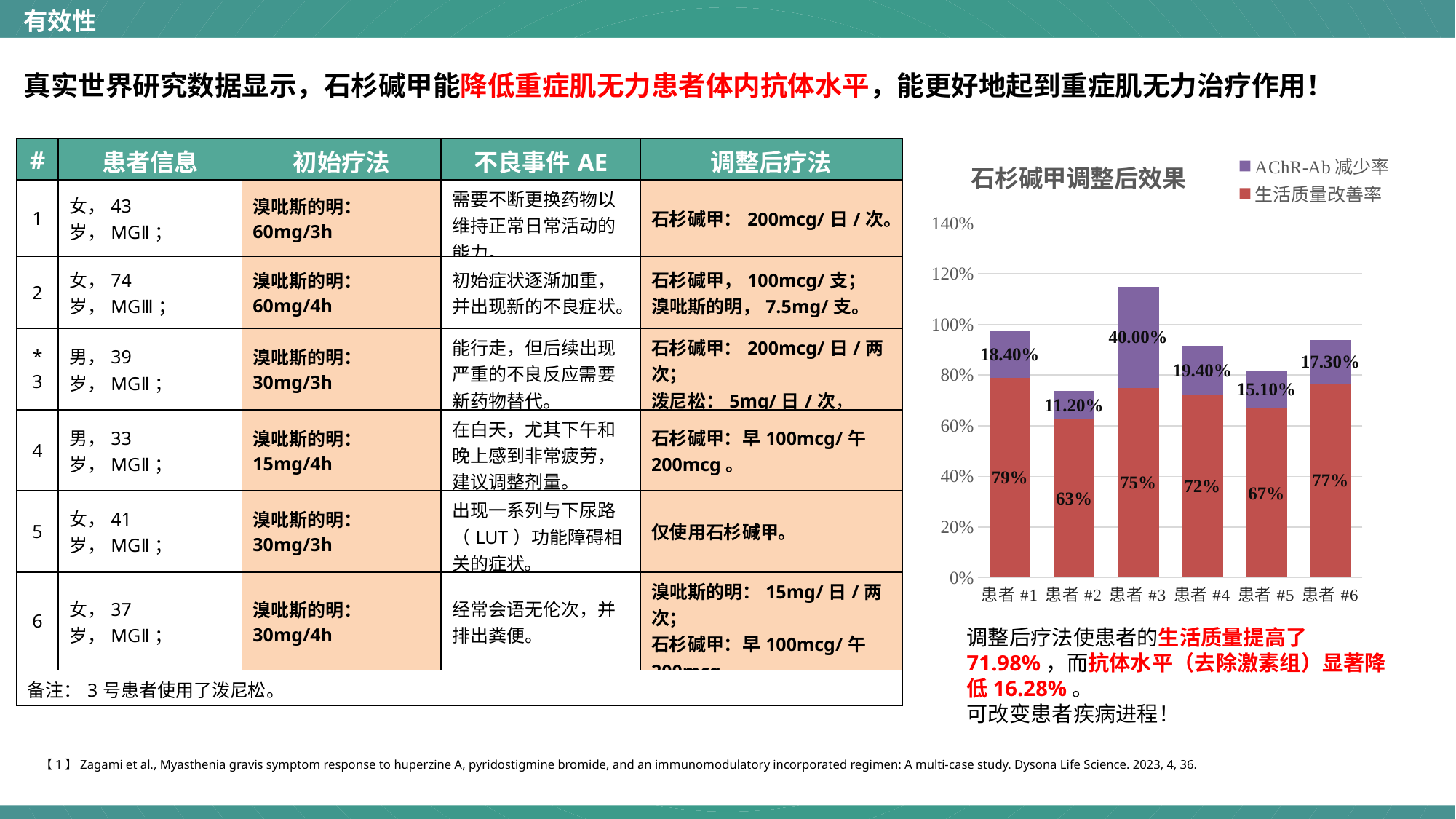
What is the title of the chart? 石杉碱甲调整后效果 How many series does the chart legend list? 2 What is the total height of the stacked bar for 患者 #3? 115.00% What is the difference in 生活质量改善率 between 患者 #1 and 患者 #2? 16% Which patient has the lowest 生活质量改善率? 患者 #2 What type of chart is shown on the slide? stacked bar chart What is the AChR-Ab 减少率 value for 患者 #5? 15.10% What is the AChR-Ab 减少率 value for 患者 #3? 40.00% Which is larger, the AChR-Ab 减少率 for 患者 #4 or for 患者 #6? 患者 #4 Which patient has the highest AChR-Ab 减少率? 患者 #3 How many patients (categories) are shown on the x axis of the chart? 6 What is the 生活质量改善率 value for 患者 #1? 79%